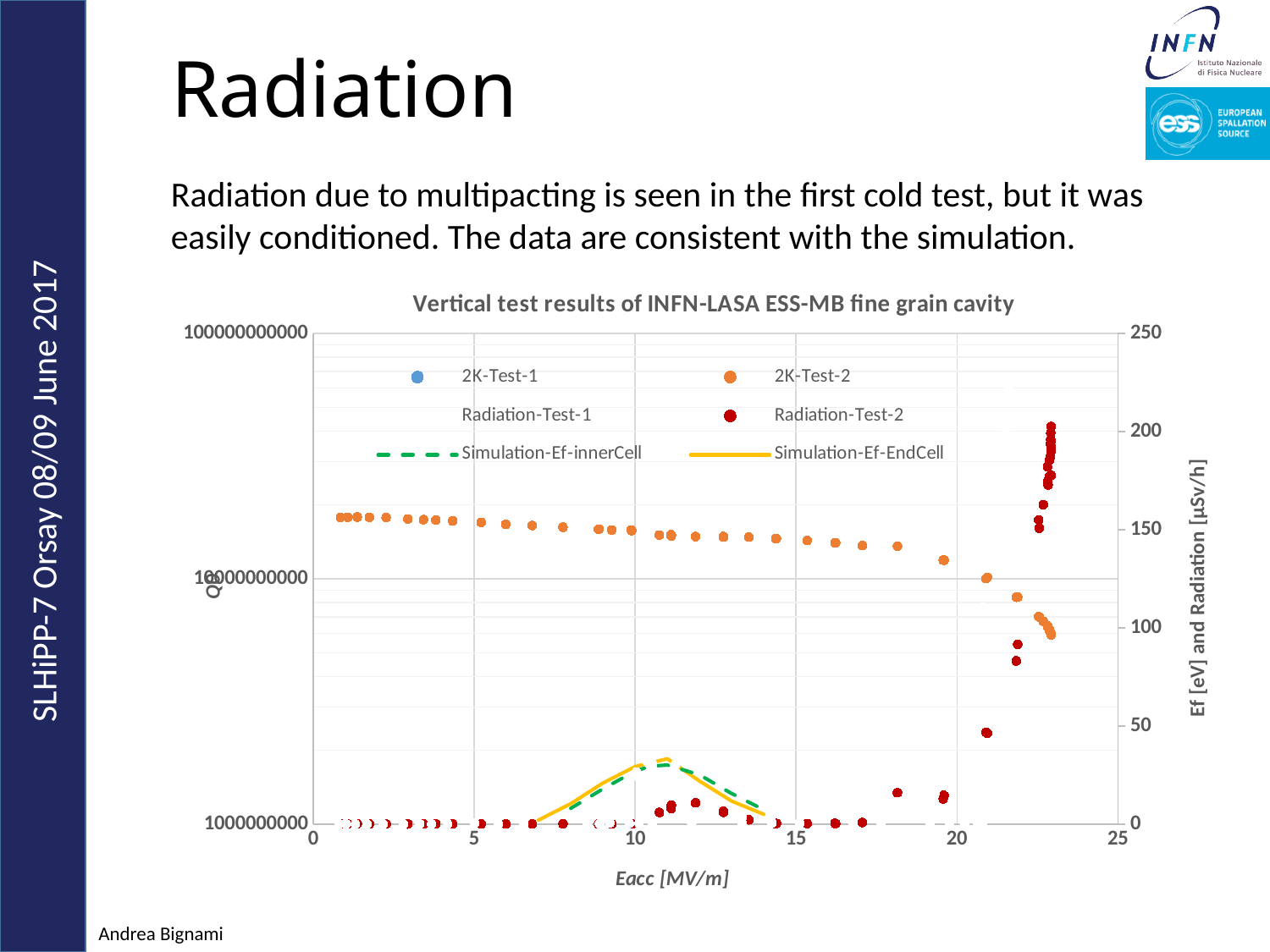
What is the title of the chart? Vertical test results of INFN-LASA ESS-MB fine grain cavity Is the highest Radiation-Test-2 value on the right axis greater or less than 150? greater Is the peak of the Simulation-Ef-EndCell curve on the right axis greater or less than 50? less What is the maximum value shown on the right-hand axis of the chart? 250 What kind of chart is shown on the slide? scatter chart How many series does the chart legend list? 6 Is the Q0 of the 2K-Test-2 series at Eacc = 5 MV/m greater or less than 10000000000? greater Does the Q0 of the 2K-Test-2 series rise or fall as Eacc increases? fall Which series reaches a higher value on the right axis, Radiation-Test-2 or Simulation-Ef-innerCell? Radiation-Test-2 What is the label of the x axis of the chart? Eacc [MV/m]